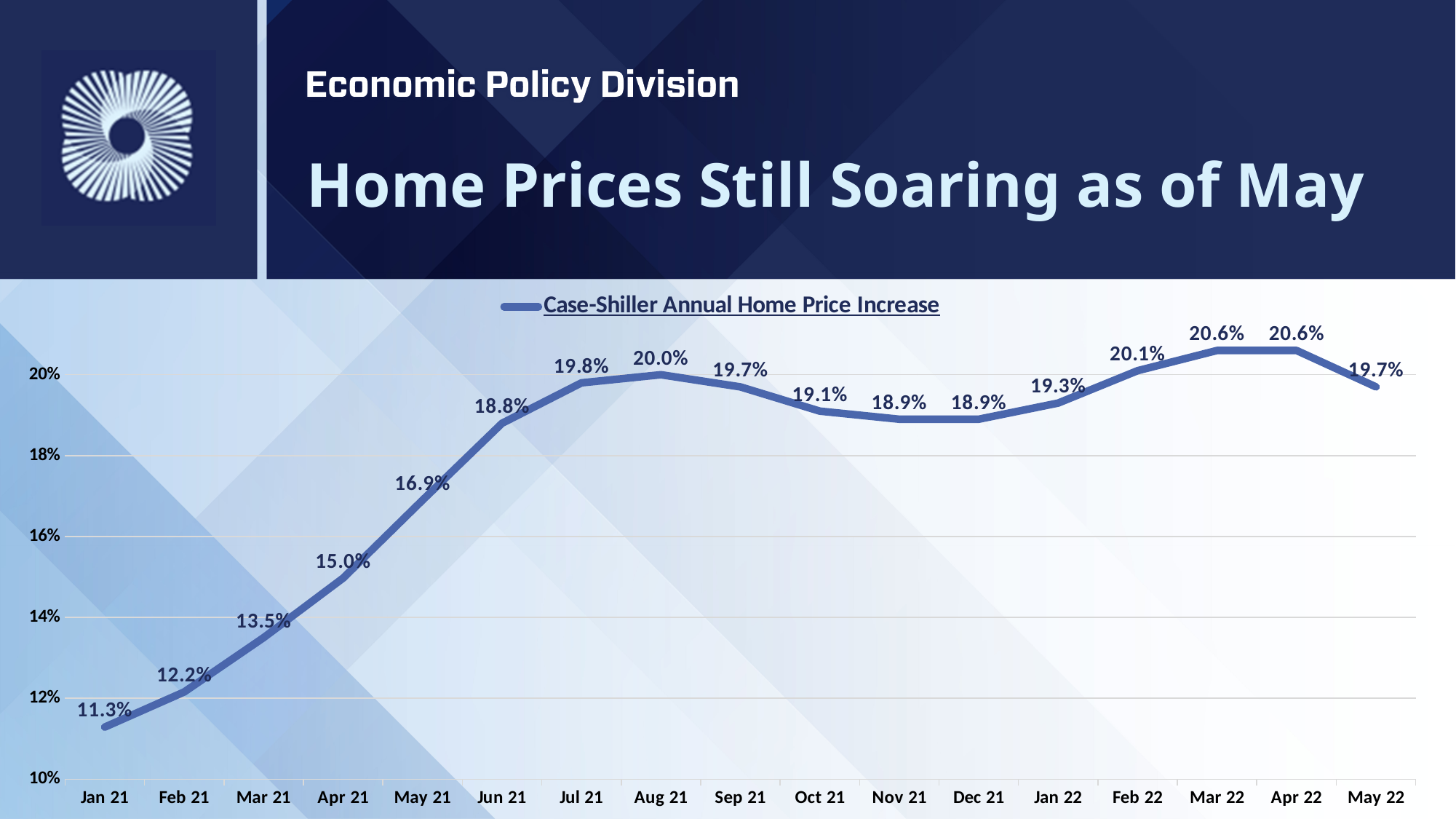
What is the Case-Shiller annual home price increase for Jan 21? 11.3% Is the value for Mar 21 greater or less than 14%? less Do the values rise or fall from Jan 21 to Aug 21? rise What is the difference between the values for Jan 21 and Jun 21? 7.5% What is the Case-Shiller annual home price increase for Aug 21? 20.0% Which month has the lowest Case-Shiller annual home price increase? Jan 21 What is the highest value plotted on the chart? 20.6% How many months are plotted on the chart? 17 Which is larger, the value for Jul 21 or the value for Oct 21? Jul 21 What is the Case-Shiller annual home price increase for May 22? 19.7% What is the difference between the values for Apr 22 and May 22? 0.9% What kind of chart is shown on the slide? line chart